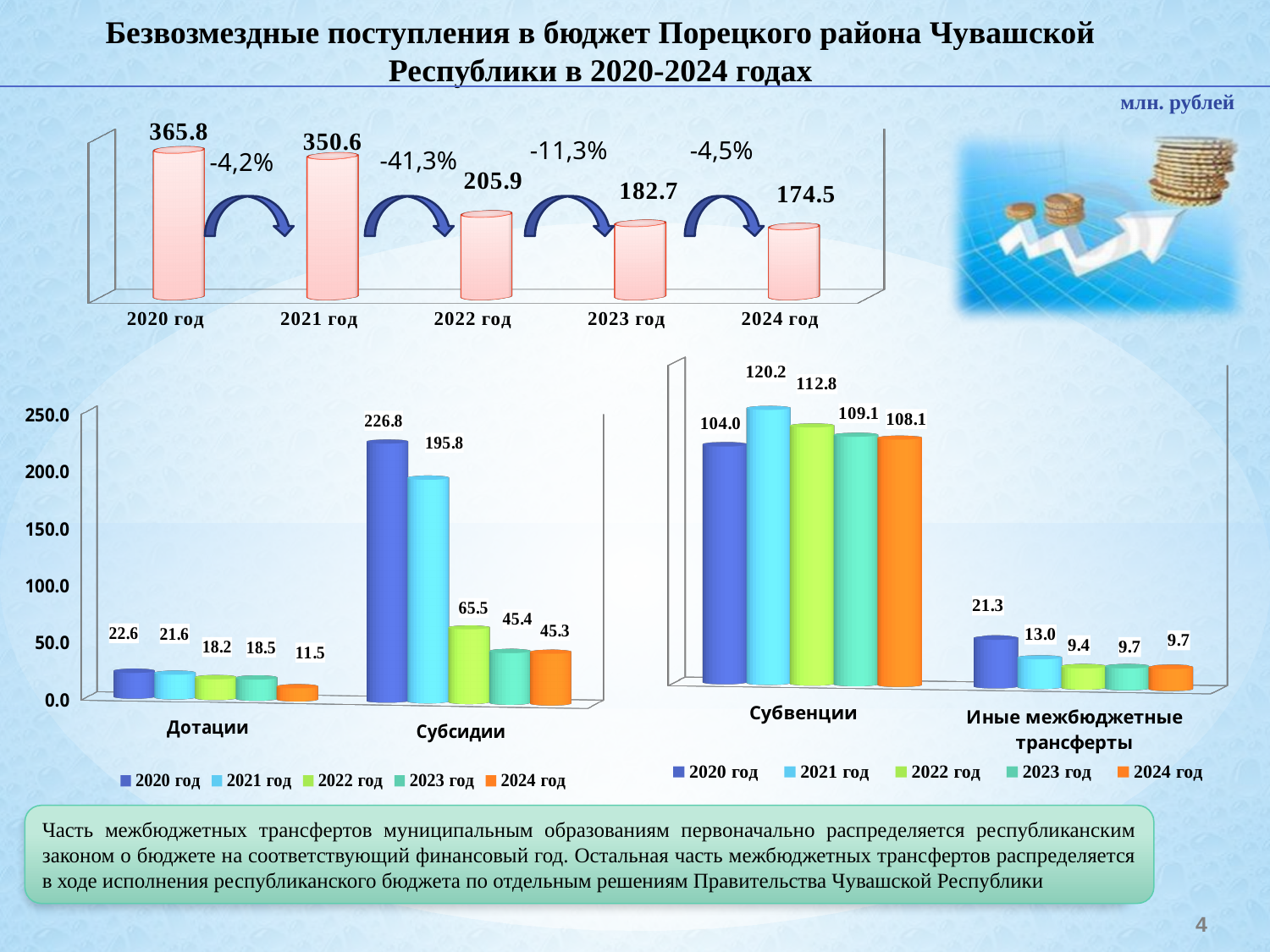
In the bottom-left chart, what is the value for Дотации in 2024 год? 11.5 In the top chart, what is the value for 2020 год? 365.8 In the bottom-right chart, which is larger: Субвенции in 2022 год or Субвенции in 2023 год? Субвенции in 2022 год In the top chart, what percentage change is shown between 2021 год and 2022 год? -41,3% In the bottom-left chart, how many series does the legend list? 5 In the top chart, do the values rise or fall from 2020 год to 2024 год? fall In the top chart, what is the difference between the values for 2021 год and 2022 год? 144.7 In the top chart, which year has the lowest value? 2024 год In the bottom-right chart, which year has the highest value for Субвенции? 2021 год In the bottom-left chart, what is the value for Субсидии in 2020 год? 226.8 In the top chart, what is the value for 2024 год? 174.5 In the bottom-right chart, what is the value for Иные межбюджетные трансферты in 2020 год? 21.3